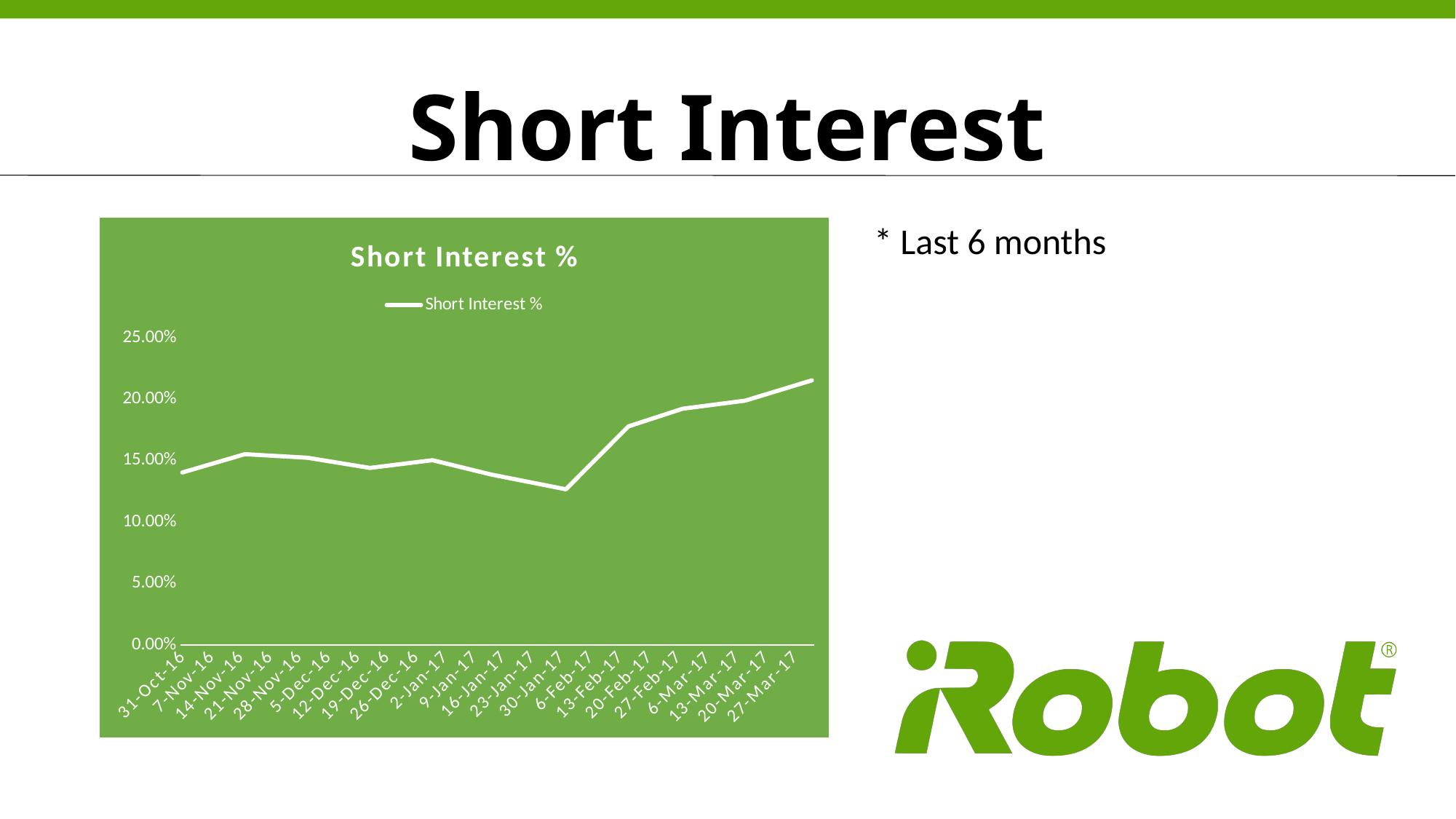
Is the Short Interest % value for 31-Oct-16 greater or less than 20.00%? less Which date has the highest Short Interest % value? 27-Mar-17 Which is larger, the Short Interest % value for 27-Mar-17 or for 31-Oct-16? 27-Mar-17 Is the lowest point on the Short Interest % line greater or less than 15.00%? less What is the title of the chart? Short Interest % Overall, does the Short Interest % line rise or fall from 31-Oct-16 to 27-Mar-17? rise Is the highest point on the Short Interest % line greater or less than 25.00%? less What kind of chart is shown on the slide? Line chart What is the highest value shown on the chart's vertical axis? 25.00% How many series does the chart legend list? 1